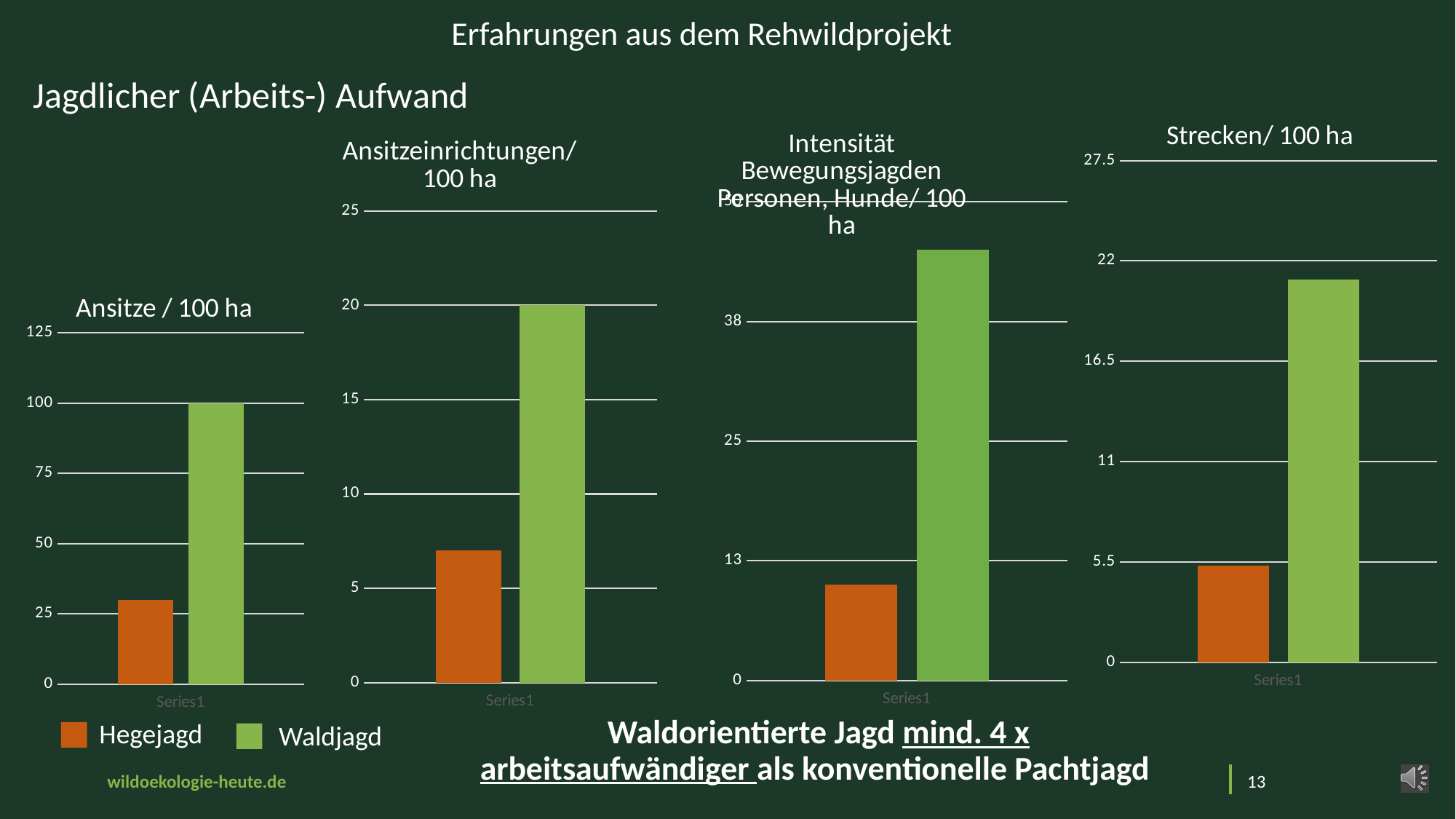
In the 'Ansitze / 100 ha' chart, is the value for Hegejagd greater or less than 50? less In the 'Intensität Bewegungsjagden' chart, is the value for Hegejagd greater or less than 13? less In the 'Ansitze / 100 ha' chart, which is larger, Hegejagd or Waldjagd? Waldjagd In the 'Ansitzeinrichtungen/ 100 ha' chart, what is the value for Waldjagd? 20 Which colour represents Hegejagd in the legend? orange In the 'Strecken/ 100 ha' chart, is the value for Waldjagd greater or less than 16.5? greater How many series does the legend list for the charts on this slide? 2 In the 'Ansitze / 100 ha' chart, what is the value for Waldjagd? 100 What kind of chart is the 'Ansitze / 100 ha' chart? bar chart In the 'Strecken/ 100 ha' chart, which series has the highest value? Waldjagd